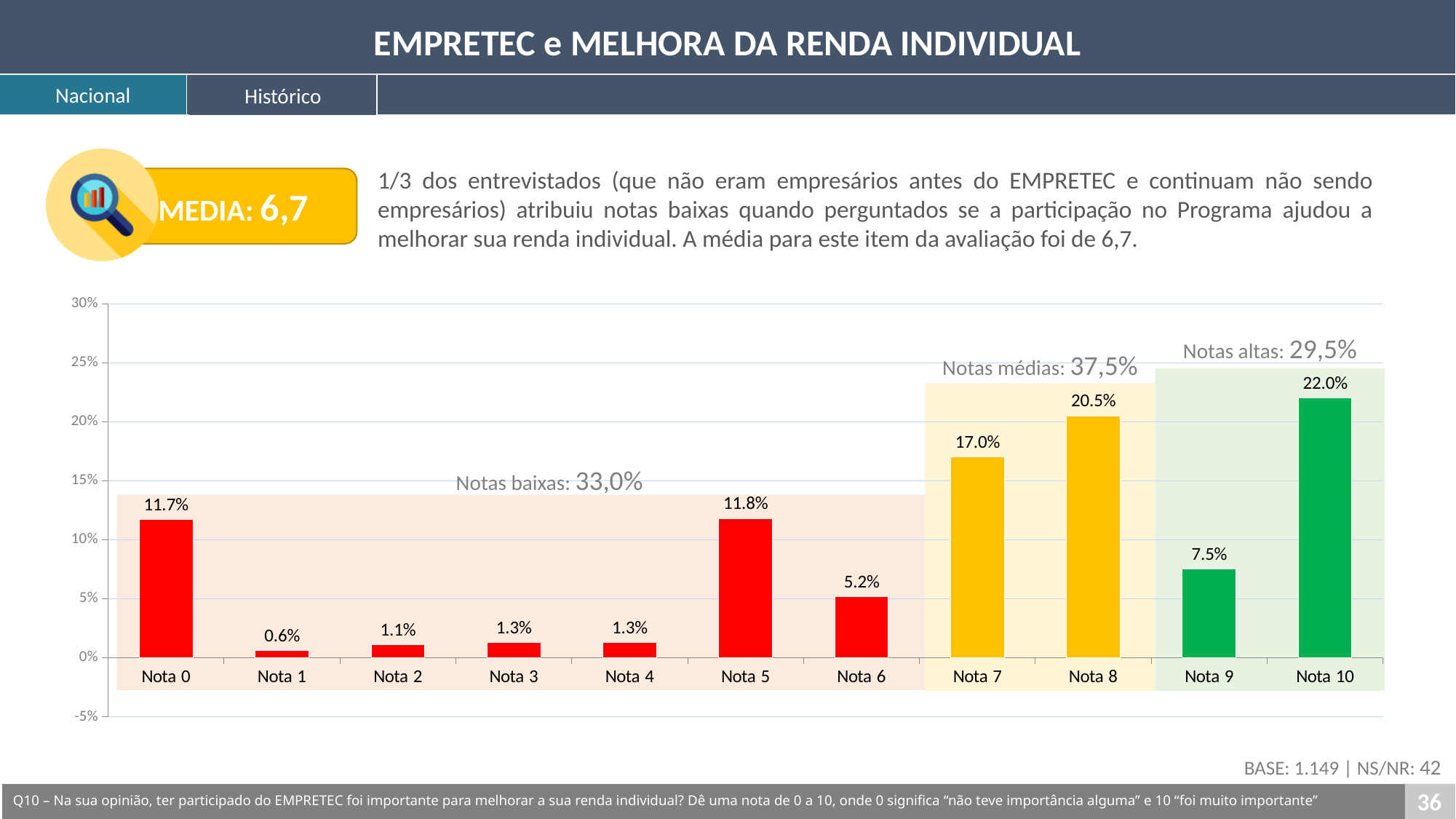
What share is labelled for 'Notas altas' on the chart? 29,5% What is the value for Nota 6? 5.2% Which is larger, the value for Nota 9 or the value for Nota 6? Nota 9 Which category has the highest value? Nota 10 What is the value for Nota 8? 20.5% Is the value for Nota 7 greater or less than 15%? greater Which category has the lowest value? Nota 1 What kind of chart is shown on the slide? bar chart What is the difference between the values for Nota 7 and Nota 9? 9.5% How many categories are shown on the x axis? 11 What is the difference between the values for Nota 10 and Nota 8? 1.5% What is the value for Nota 0? 11.7%